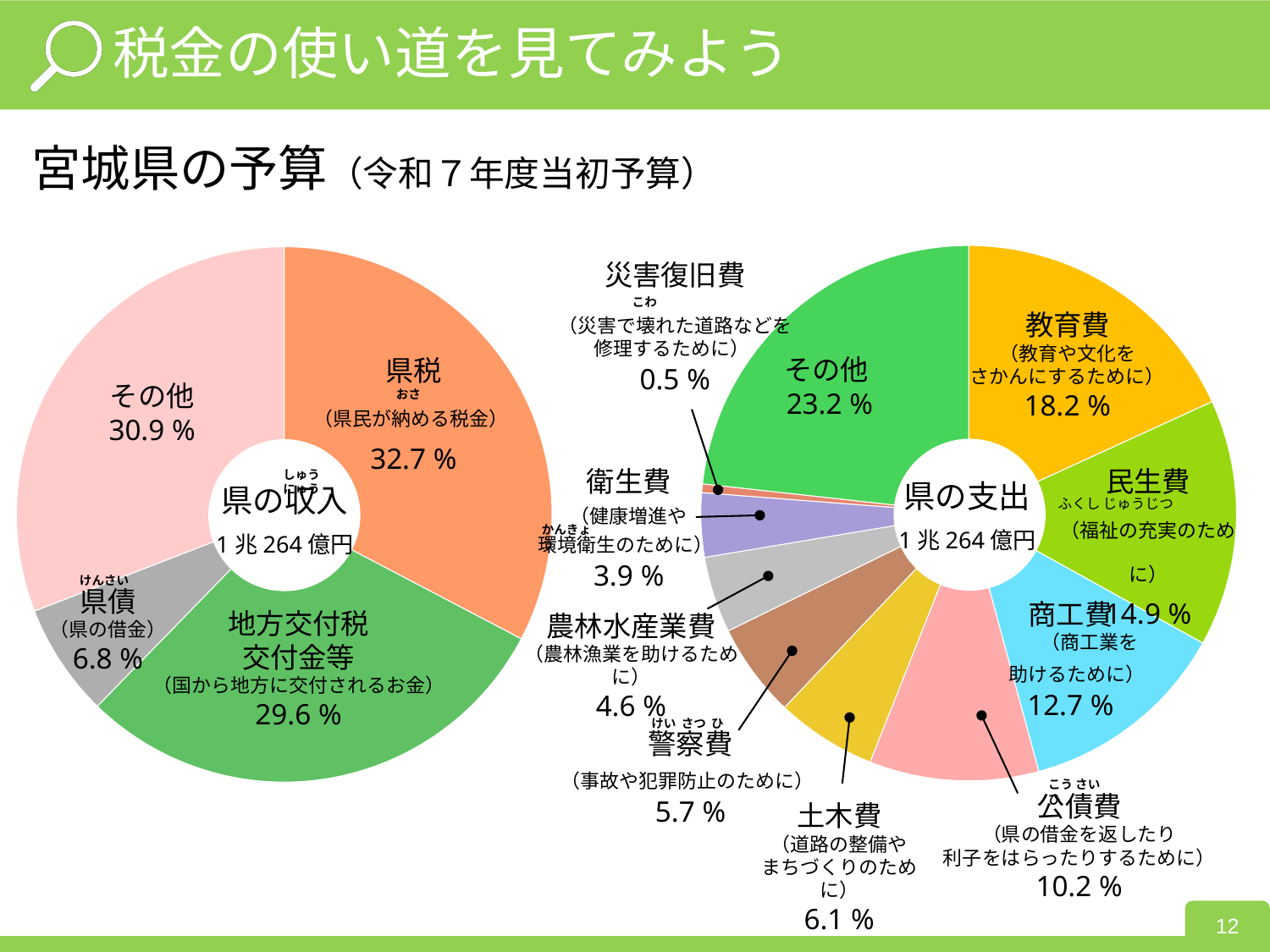
In the 県の支出 chart, what share does 教育費 account for? 18.2 % In the 県の収入 chart, which category has the largest share? 県税 In the 県の収入 chart, what share does 県債 account for? 6.8 % What kind of chart is used for 県の収入 and 県の支出? Pie (donut) chart In the 県の収入 chart, how many categories are shown? 4 In the 県の支出 chart, what share does 災害復旧費 account for? 0.5 % In the 県の収入 chart, what is the difference in percentage points between 県税 and 地方交付税交付金等? 3.1 In the 県の支出 chart, which named expense category (excluding その他) has the largest share? 教育費 In the 県の収入 chart, what share does 県税 account for? 32.7 % In the 県の支出 chart, what is the difference in percentage points between 民生費 and 衛生費? 11.0 In the 県の支出 chart, which is larger, 商工費 or 公債費? 商工費 In the 県の収入 chart, which category has the smallest share? 県債